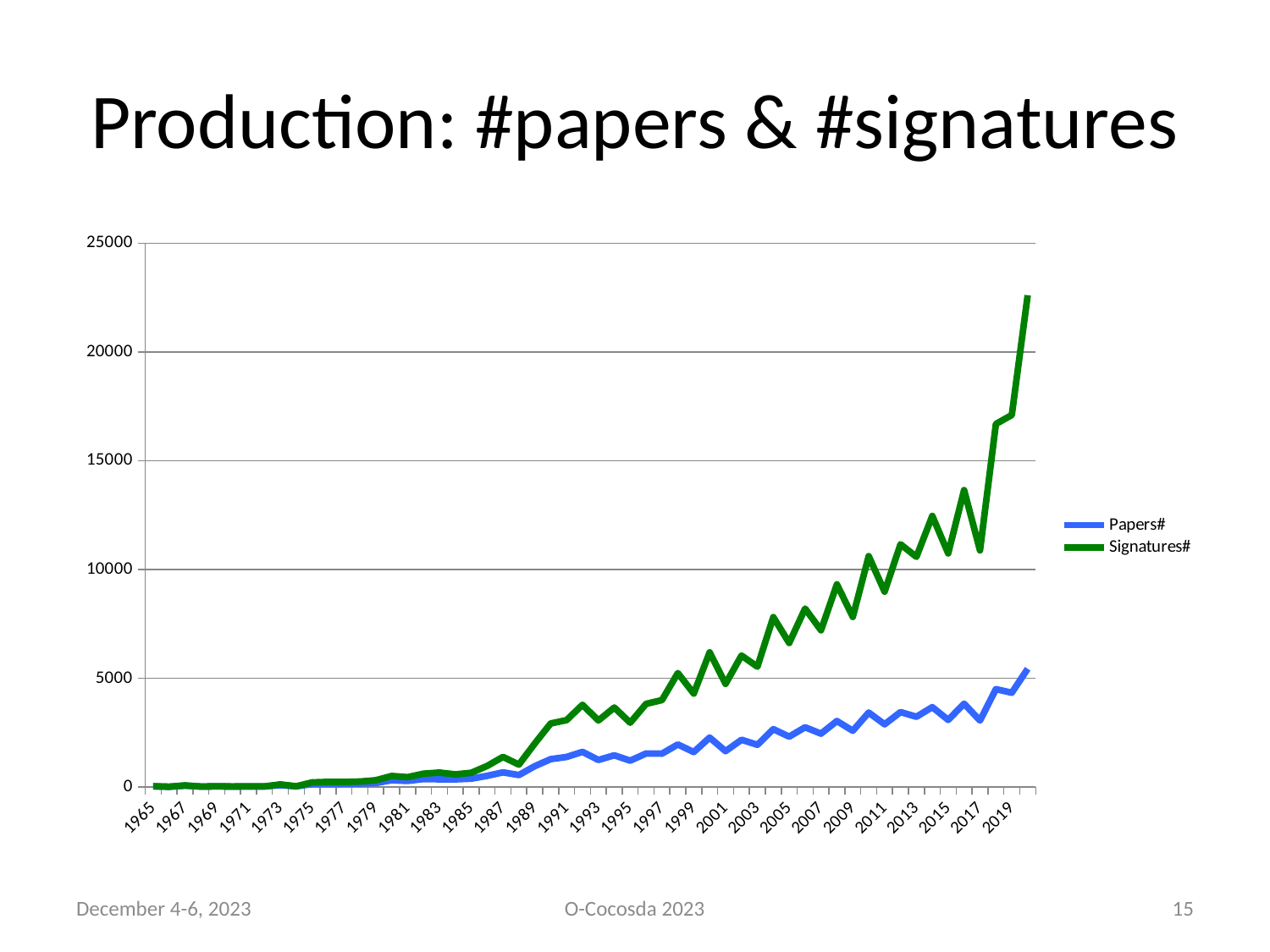
What is the title of the slide chart? Production: #papers & #signatures Is the Signatures# value for 2005 greater or less than 5000? greater How many year labels are shown on the x axis? 28 Is the Signatures# value for 2019 greater or less than 15000? greater What kind of chart is shown on the slide? line chart Which series has the higher value in 2015, Papers# or Signatures#? Signatures# Do the Signatures# values generally rise or fall from 1965 to the right end of the x axis? rise What colour is the Papers# line? blue Is the Signatures# value for 1985 greater or less than 5000? less How many series does the legend list? 2 Which series reaches the highest value on the chart? Signatures#